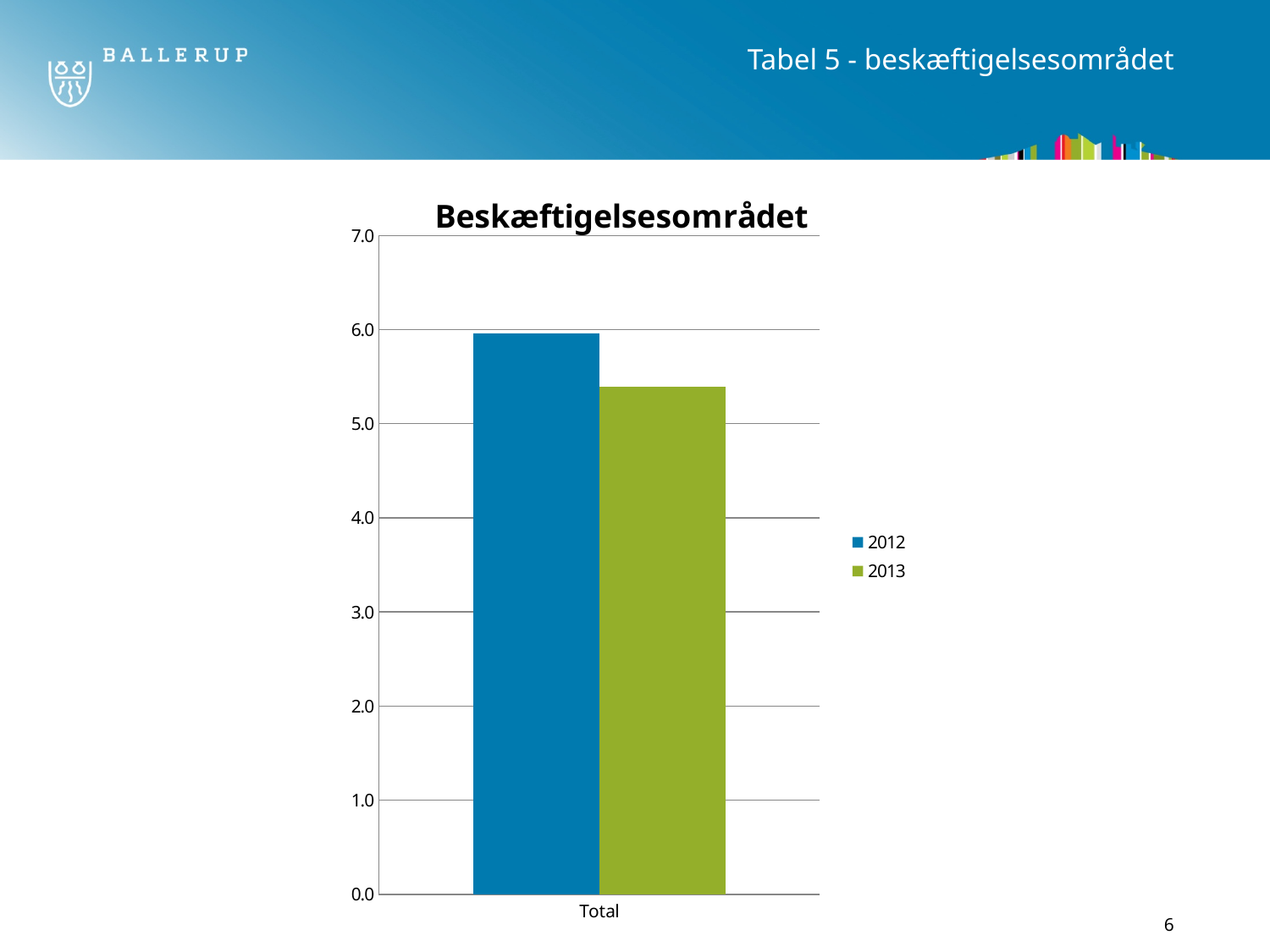
What kind of chart is shown on the slide? bar chart Which colour represents the 2013 series in the legend? green Which series has the lowest value for Total? 2013 Is the value for 2013 in the Total category greater or less than 5.0? greater Which series has the taller bar for Total, 2012 or 2013? 2012 Is the value for 2013 in the Total category greater or less than 6.0? less What is the title of the chart? Beskæftigelsesområdet How many series does the legend list? 2 Is the value for 2012 in the Total category greater or less than 7.0? less How many categories are shown on the x axis? 1 What is the label of the category on the x axis? Total